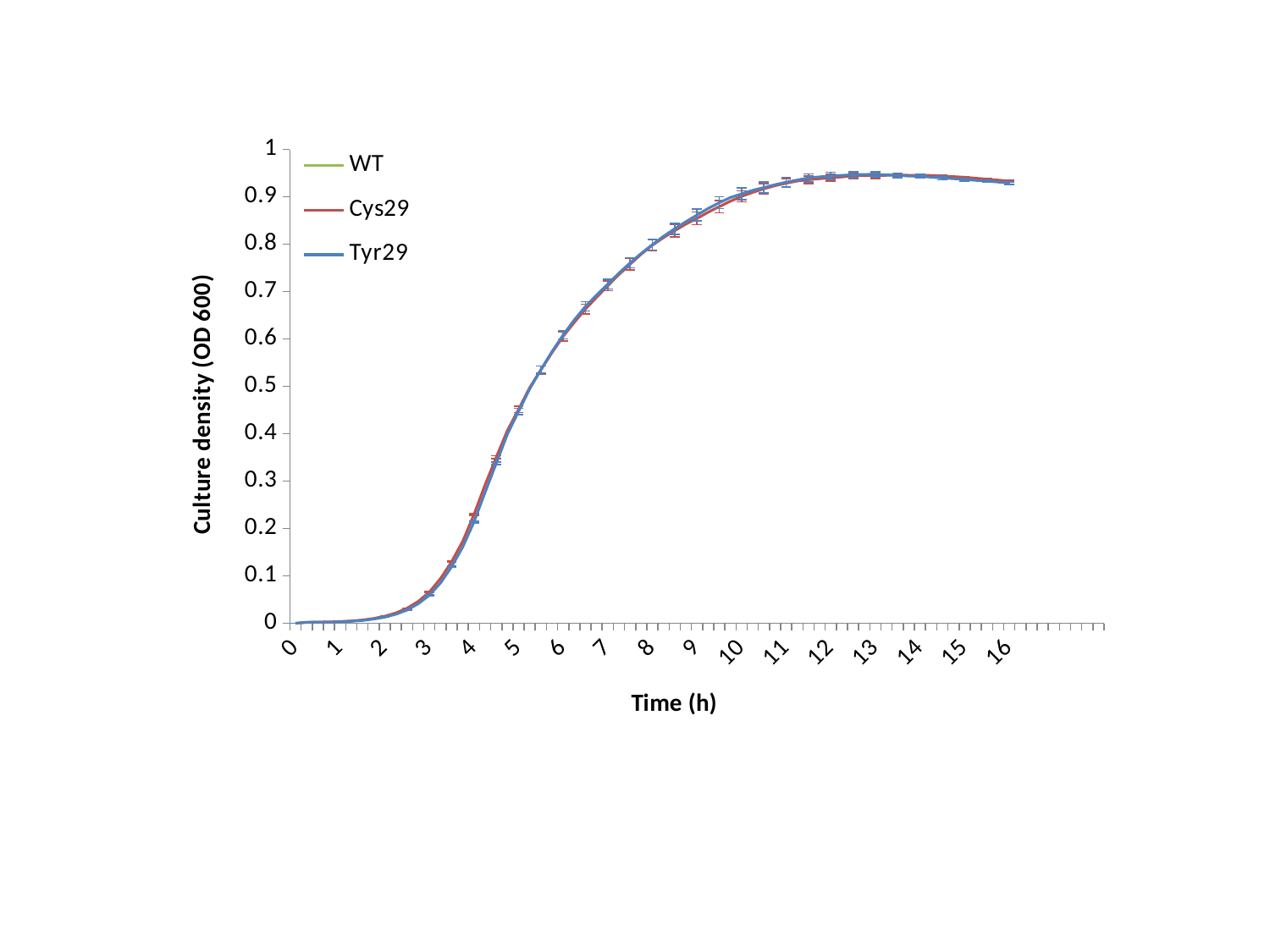
How many series does the legend list? 3 What is the title of the y axis? Culture density (OD 600) Is the culture density for Tyr29 at 12 h greater or less than 0.9? greater What kind of chart is shown on the slide? line chart Is the culture density for Cys29 at 4 h greater or less than 0.3? less How many labelled tick values are shown on the x axis? 17 Is the culture density for Tyr29 at 8 h greater or less than 0.7? greater What are the three series named in the legend? WT, Cys29, Tyr29 Does culture density rise or fall between 0 h and 10 h? rise What is the highest value shown on the y axis? 1